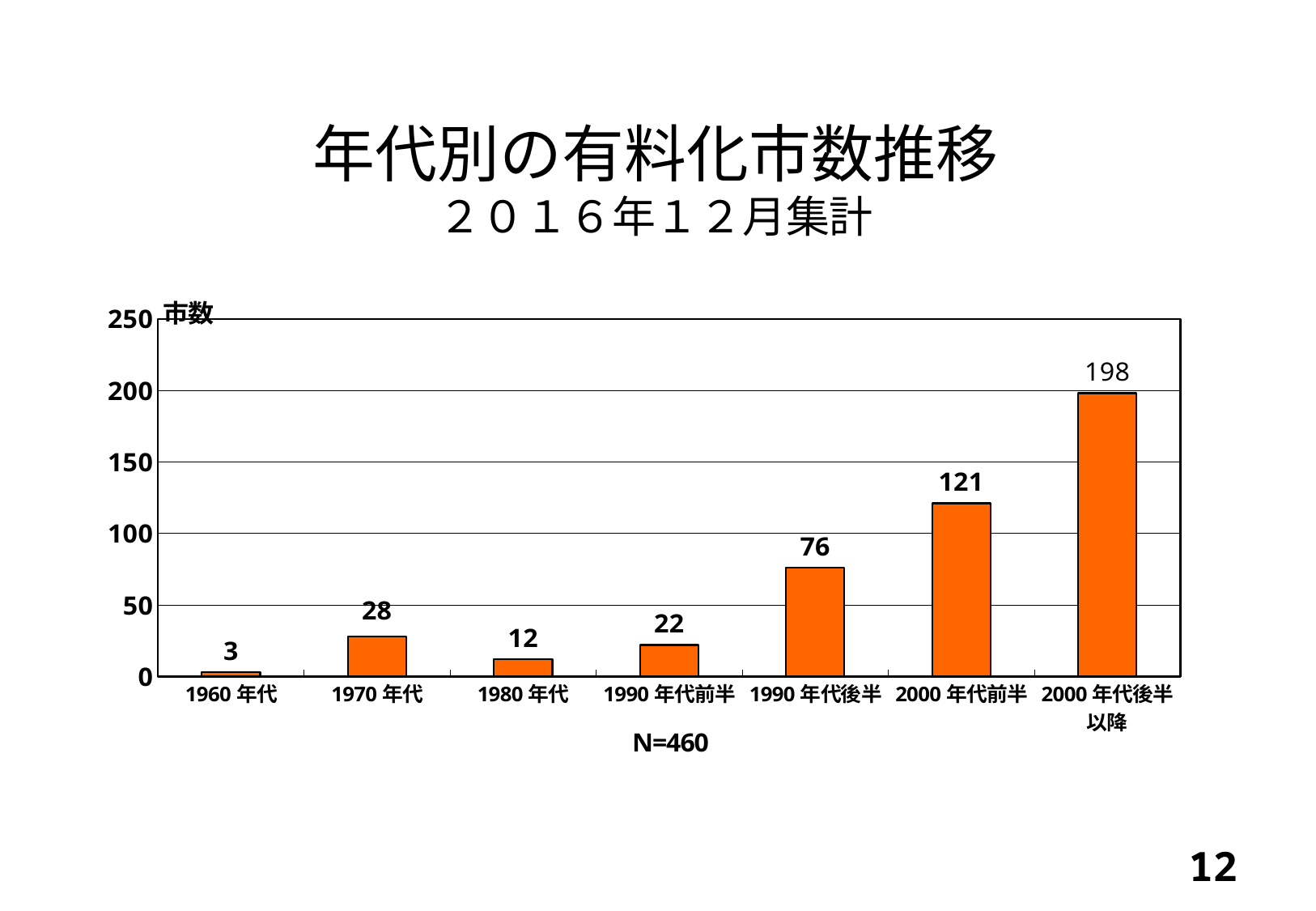
What is the value for 1960年代? 3 What is the sample size (N) shown below the chart? N=460 What is the difference between the values for 2000年代後半以降 and 2000年代前半? 77 Is the value for 2000年代前半 greater or less than 100? greater Which category has the lowest value? 1960年代 Which is larger, the value for 1970年代 or the value for 1980年代? 1970年代 Which category has the highest value? 2000年代後半以降 Do the values generally rise or fall from 1990年代前半 to 2000年代後半以降? rise What is the value for 1990年代後半? 76 What kind of chart is shown on the slide? bar chart How many categories are shown on the x axis? 7 What is the value for 2000年代後半以降? 198